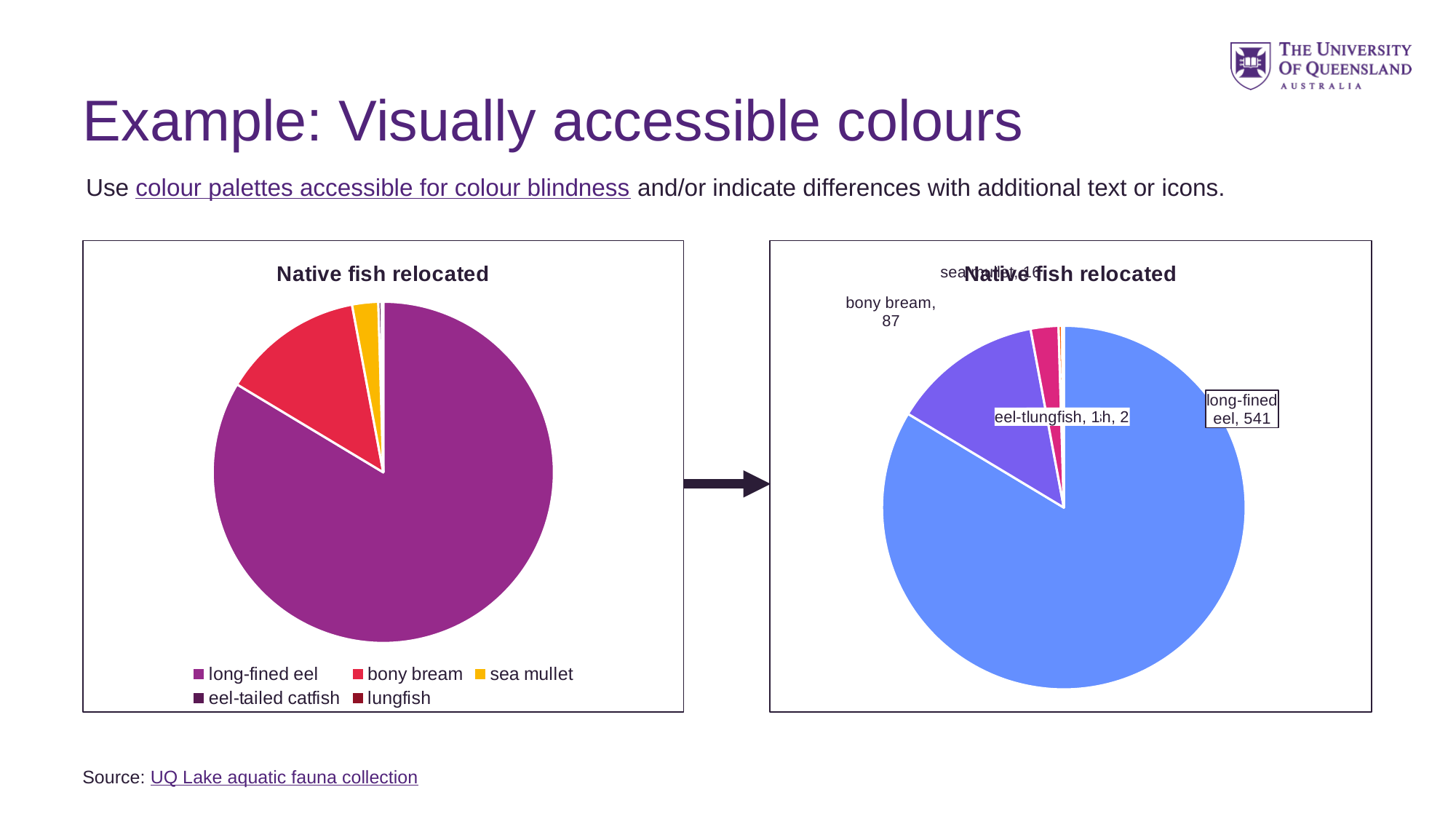
In the left-hand chart, which is larger: bony bream or sea mullet? bony bream In the right-hand chart, which is larger: long-fined eel or bony bream? long-fined eel In the right-hand chart, what is the value for bony bream? 87 In the right-hand chart, which category has the largest slice? long-fined eel In the left-hand chart, which category has the largest slice? long-fined eel What type of chart is shown on the left side of the slide? pie chart What is the title of the left-hand chart? Native fish relocated In the right-hand chart, what is the value for long-fined eel? 541 How many categories does the legend of the left-hand chart list? 5 In the left-hand chart's legend, which category is shown in yellow? sea mullet In the right-hand chart, what is the difference between the long-fined eel value and the bony bream value? 454